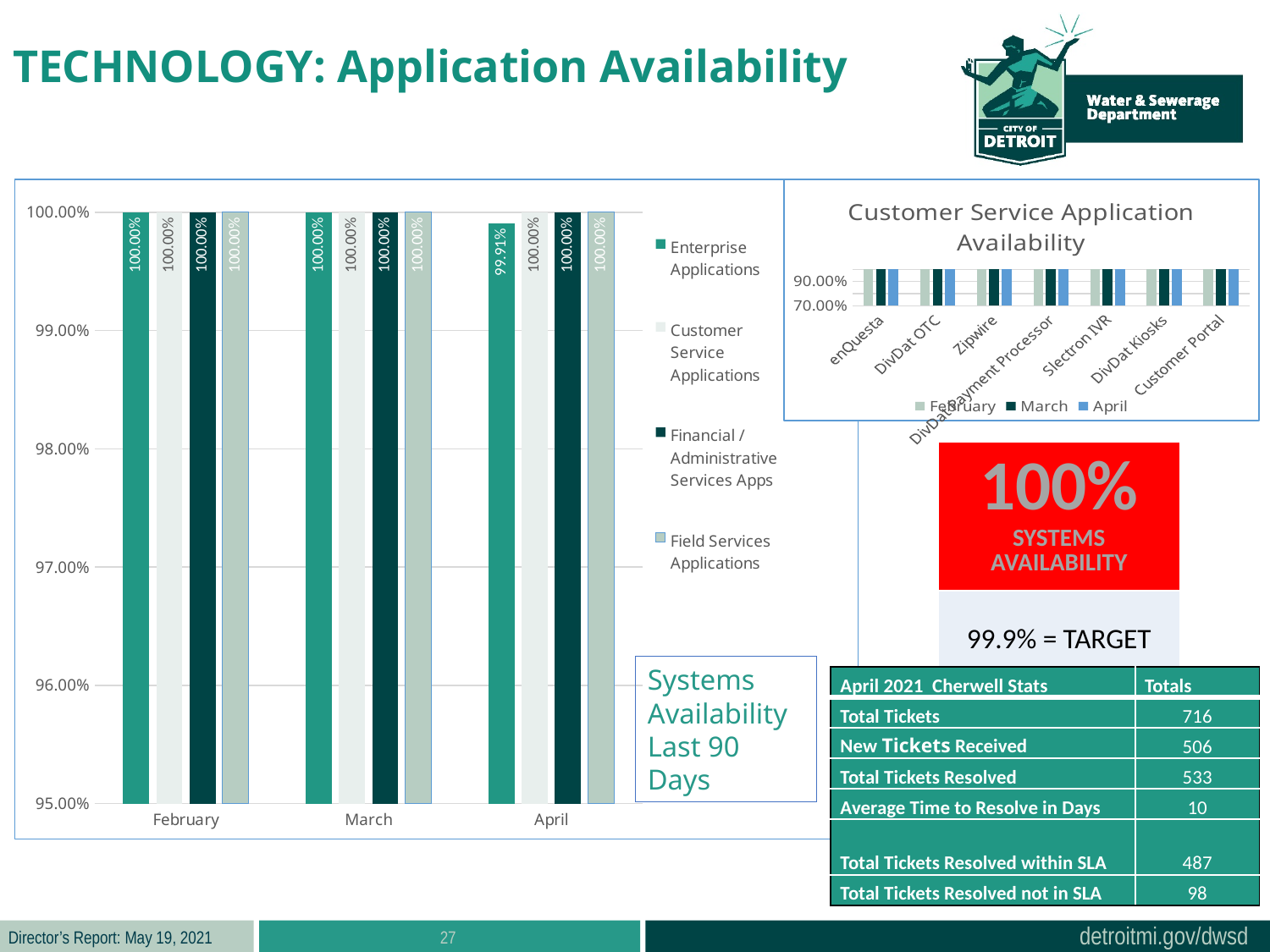
What kind of chart is the Systems Availability Last 90 Days chart? Bar chart On the Systems Availability Last 90 Days chart, which is larger in April: Enterprise Applications or Customer Service Applications? Customer Service Applications On the Systems Availability Last 90 Days chart, what is the value for Field Services Applications in February? 100.00% On the Systems Availability Last 90 Days chart, what is the value for Enterprise Applications in April? 99.91% On the Customer Service Application Availability chart, how many applications are shown on the x axis? 7 On the Customer Service Application Availability chart, is the value for enQuesta in April greater or less than 90.00%? greater On the Systems Availability Last 90 Days chart, what is the difference between the Financial / Administrative Services Apps value and the Enterprise Applications value in April? 0.09% On the Systems Availability Last 90 Days chart, how many series does the legend list? 4 On the Systems Availability Last 90 Days chart, which month has the lowest value for Enterprise Applications? April On the Systems Availability Last 90 Days chart, how many months are shown on the x axis? 3 On the Customer Service Application Availability chart, how many series does the legend list? 3 On the Systems Availability Last 90 Days chart, what is the value for Customer Service Applications in March? 100.00%